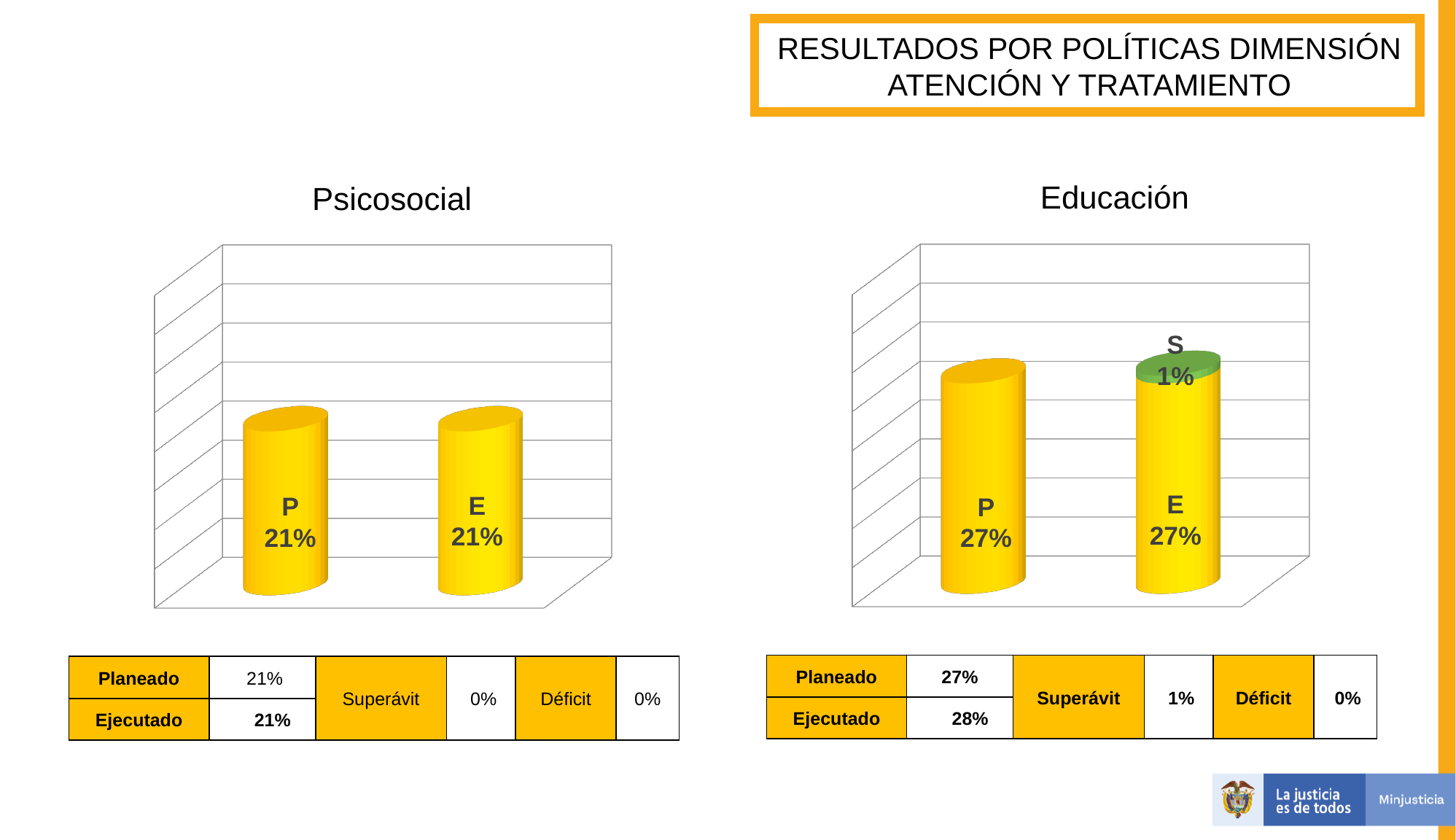
In the Psicosocial chart, what is the value labelled on the P bar? 21% In the Psicosocial chart, what is the value labelled on the E bar? 21% In the Educación chart, what is the value labelled on the P bar? 27% Which chart on the slide has a green segment stacked on top of a bar? Educación How many bars are plotted in the Psicosocial chart? 2 In the Psicosocial chart, what is the difference between the P value and the E value? 0% In the Educación chart, what value is labelled on the green S segment on top of the E bar? 1% In the Educación chart, what is the difference between the E value and the S value? 26% How many bars are plotted in the Educación chart? 2 What is the title of the chart on the left side of the slide? Psicosocial What kind of chart is the Educación chart? Bar chart In the Educación chart, what is the total of the stacked E bar (E plus S)? 28%